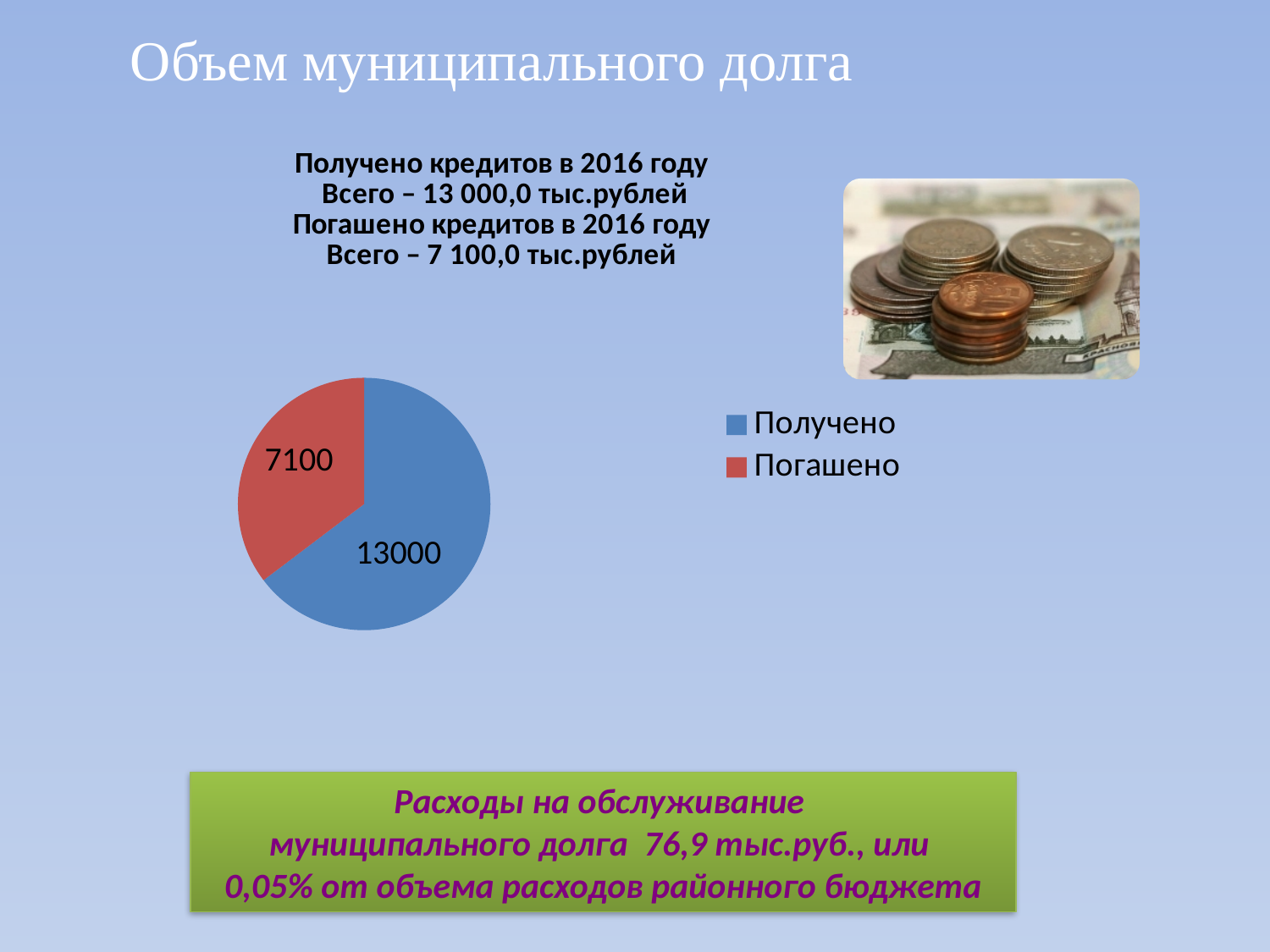
What colour is the Получено slice in the pie chart? Blue Which is larger in the pie chart, Получено or Погашено? Получено What is the total of the two values shown in the pie chart? 20100 What kind of chart is shown on the slide? Pie chart What is the difference between the Получено and Погашено values in the pie chart? 5900 What value is shown for the Погашено slice of the pie chart? 7100 Which slice of the pie chart is the largest? Получено What colour is the Погашено slice in the pie chart? Red How many entries does the legend of the pie chart list? 2 What value is shown for the Получено slice of the pie chart? 13000 How many slices does the pie chart have? 2 Which slice of the pie chart is the smallest? Погашено